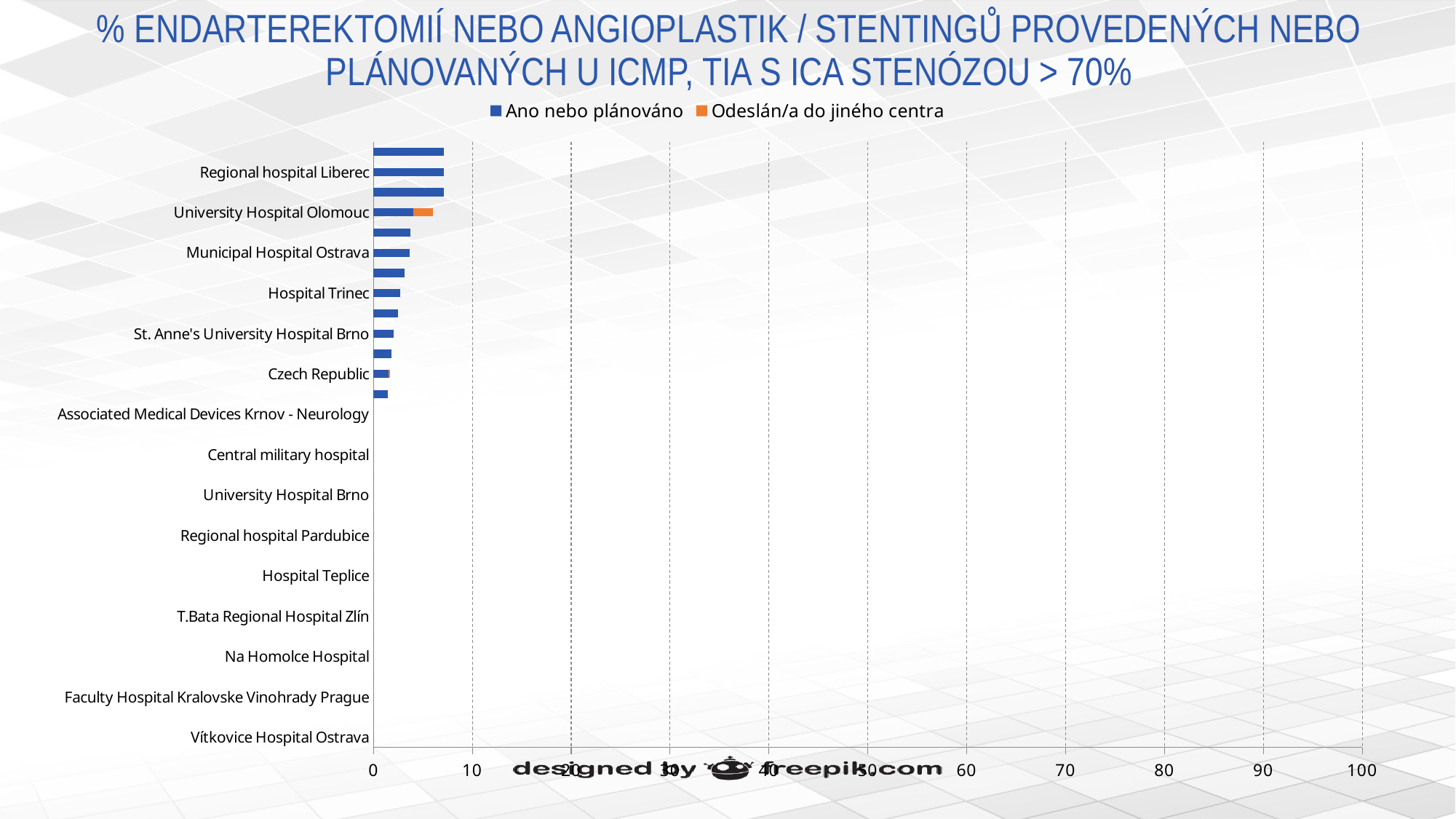
Among the labeled categories, which has the highest 'Ano nebo plánováno' value? Regional hospital Liberec Is the value for Regional hospital Liberec greater or less than 10? less Which series is shown in orange in the legend? Odeslán/a do jiného centra How many category labels are readable on the vertical axis? 15 Which has the larger 'Ano nebo plánováno' value, Hospital Trinec or Czech Republic? Hospital Trinec Which has the larger 'Ano nebo plánováno' value, Regional hospital Liberec or University Hospital Olomouc? Regional hospital Liberec Which has the larger 'Ano nebo plánováno' value, Municipal Hospital Ostrava or St. Anne's University Hospital Brno? Municipal Hospital Ostrava What kind of chart is shown on the slide? Bar chart Is the value for Vítkovice Hospital Ostrava greater or less than 10? less What is the maximum value shown on the horizontal axis? 100 Is the value for University Hospital Olomouc greater or less than 10? less How many series does the legend list? 2